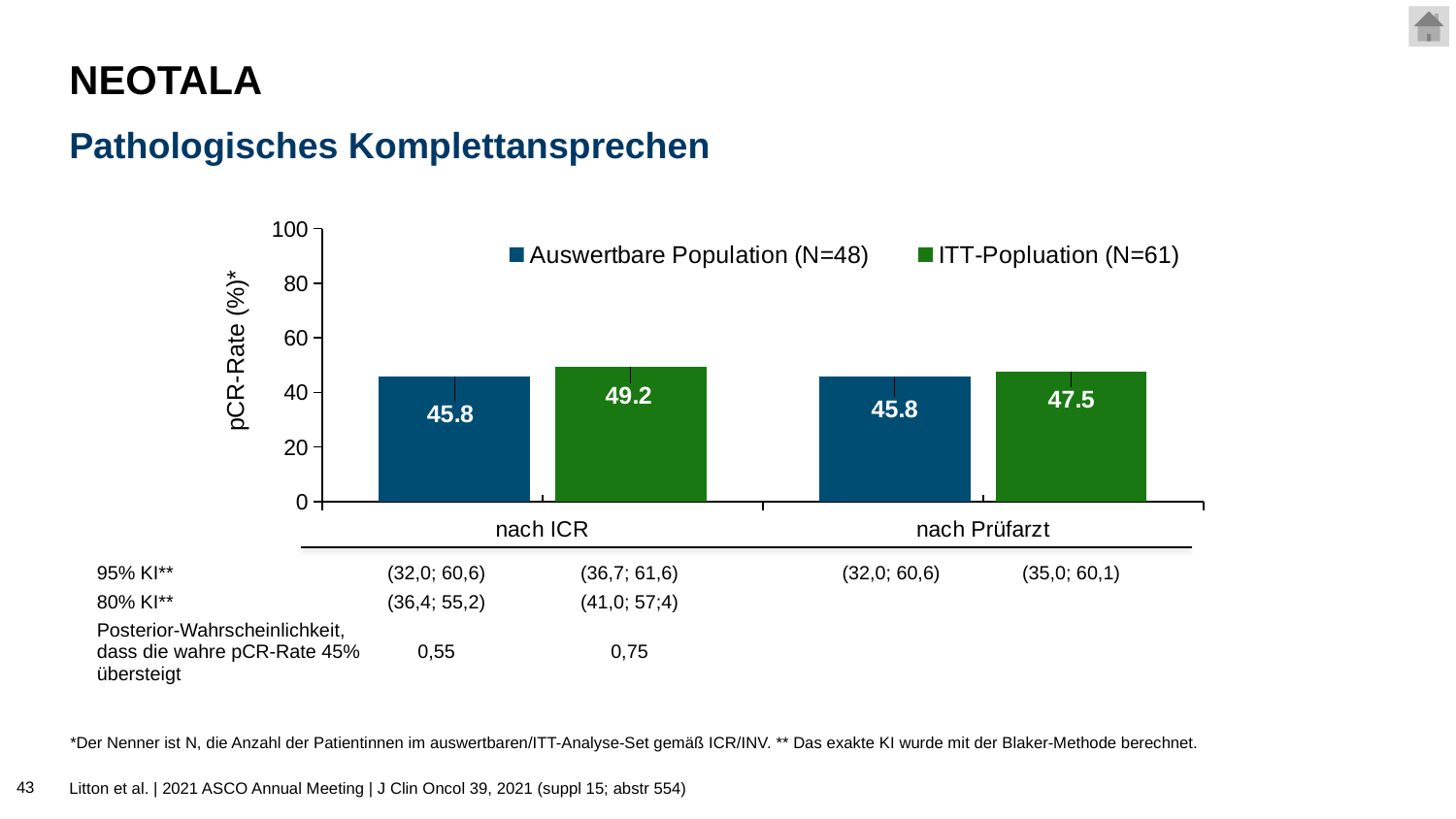
What is the label of the y axis? pCR-Rate (%)* What is the difference between the ITT-Population pCR rate nach ICR and nach Prüfarzt? 1.7 What is the pCR rate for the ITT-Population (N=61) nach ICR? 49.2 How many series does the legend list? 2 What is the difference between the ITT-Population and the Auswertbare Population pCR rates nach ICR? 3.4 Is the pCR rate for the ITT-Population nach ICR greater or less than 40? greater Which is larger nach Prüfarzt: the Auswertbare Population or the ITT-Population pCR rate? ITT-Population How many categories are shown on the x axis? 2 Which bar shows the highest pCR rate? ITT-Population (N=61) nach ICR What kind of chart is shown on the slide? bar chart What is the pCR rate for the Auswertbare Population (N=48) nach Prüfarzt? 45.8 What is the pCR rate for the ITT-Population (N=61) nach Prüfarzt? 47.5